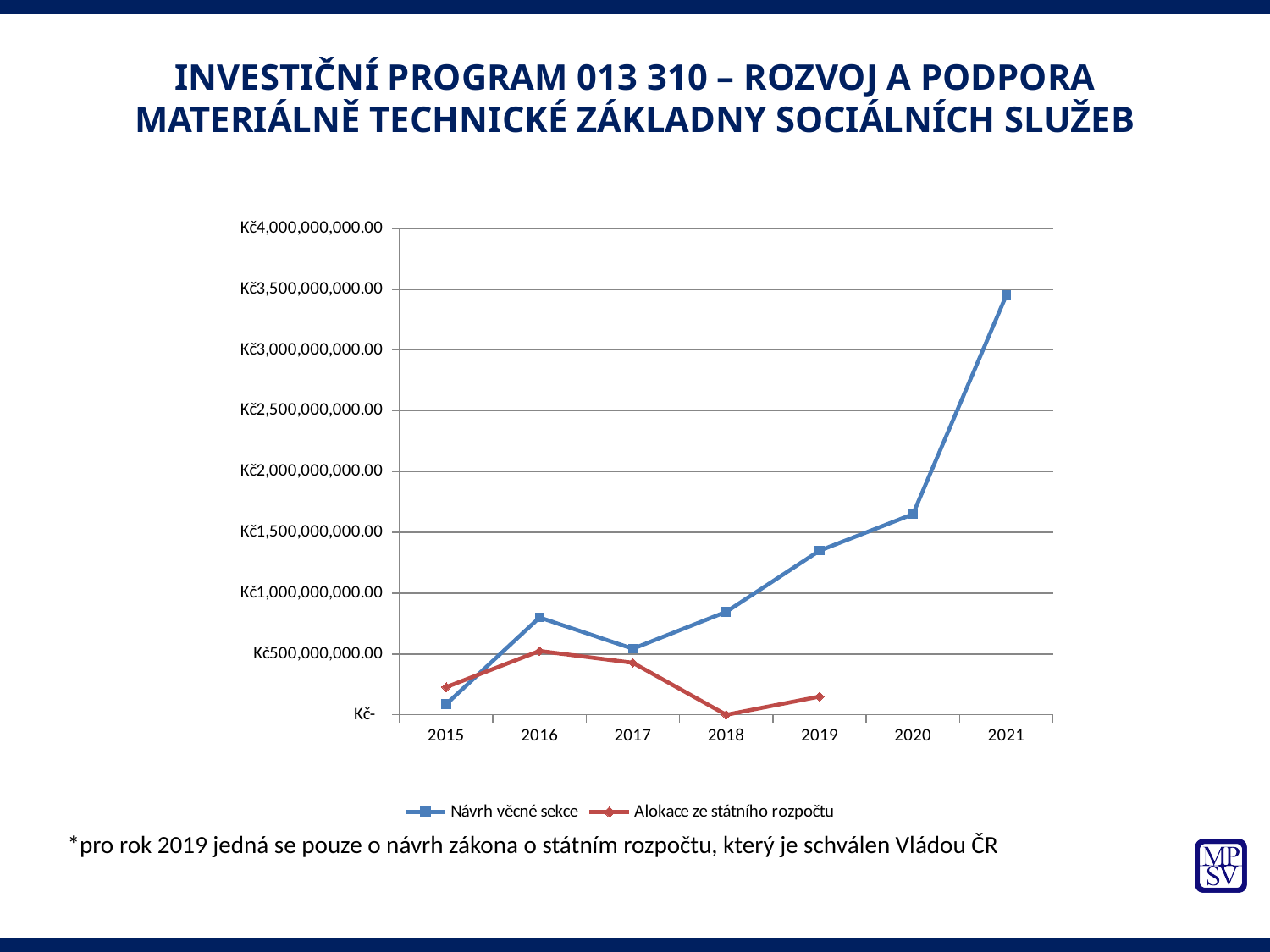
How many years are shown on the x axis? 7 Is the value for Návrh věcné sekce in 2019 greater or less than Kč1,000,000,000.00? greater Is the value for Návrh věcné sekce in 2021 greater or less than Kč3,000,000,000.00? greater Which series has the larger value in 2019, Návrh věcné sekce or Alokace ze státního rozpočtu? Návrh věcné sekce In which year is the value for Alokace ze státního rozpočtu lowest? 2018 How many series does the legend list? 2 Does the value for Návrh věcné sekce rise or fall from 2018 to 2021? Rise In which year is the value for Návrh věcné sekce lowest? 2015 In which year is the value for Alokace ze státního rozpočtu highest? 2016 What kind of chart is shown on the slide? Line chart In which year is the value for Návrh věcné sekce highest? 2021 Is the value for Alokace ze státního rozpočtu in 2015 greater or less than Kč500,000,000.00? less